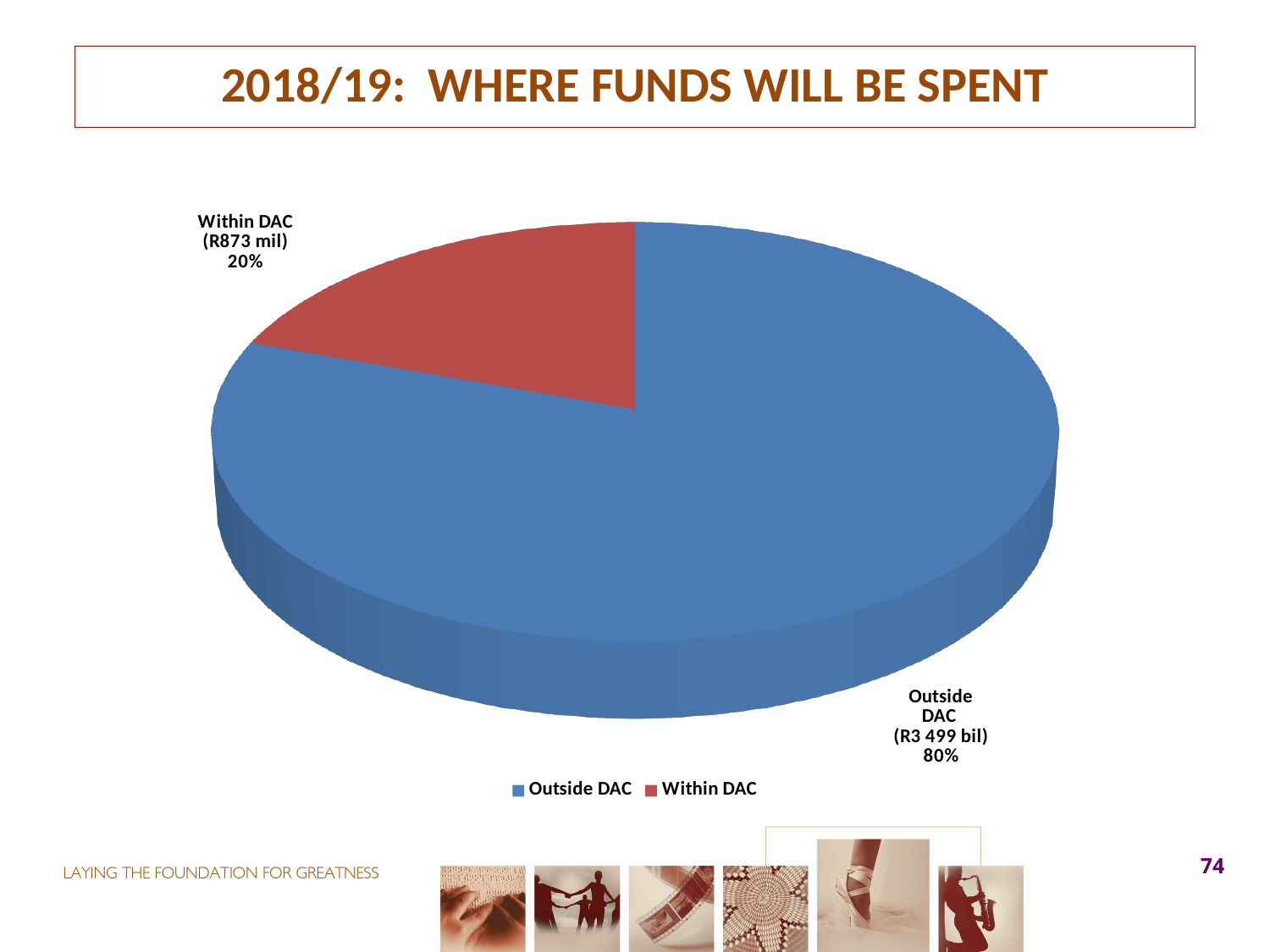
How many slices does the pie chart have? 2 Which slice of the pie is the largest? Outside DAC What kind of chart is shown on the slide? Pie chart What amount is shown for Within DAC? R873 mil Which slice of the pie is the smallest? Within DAC What percentage of funds will be spent Within DAC? 20% What amount is shown for Outside DAC? R3 499 bil What percentage of funds will be spent Outside DAC? 80% How many entries does the legend list? 2 What is the difference in percentage points between the Outside DAC and Within DAC shares? 60 percentage points What colour is the Within DAC slice? Red Which is larger, the share for Outside DAC or Within DAC? Outside DAC